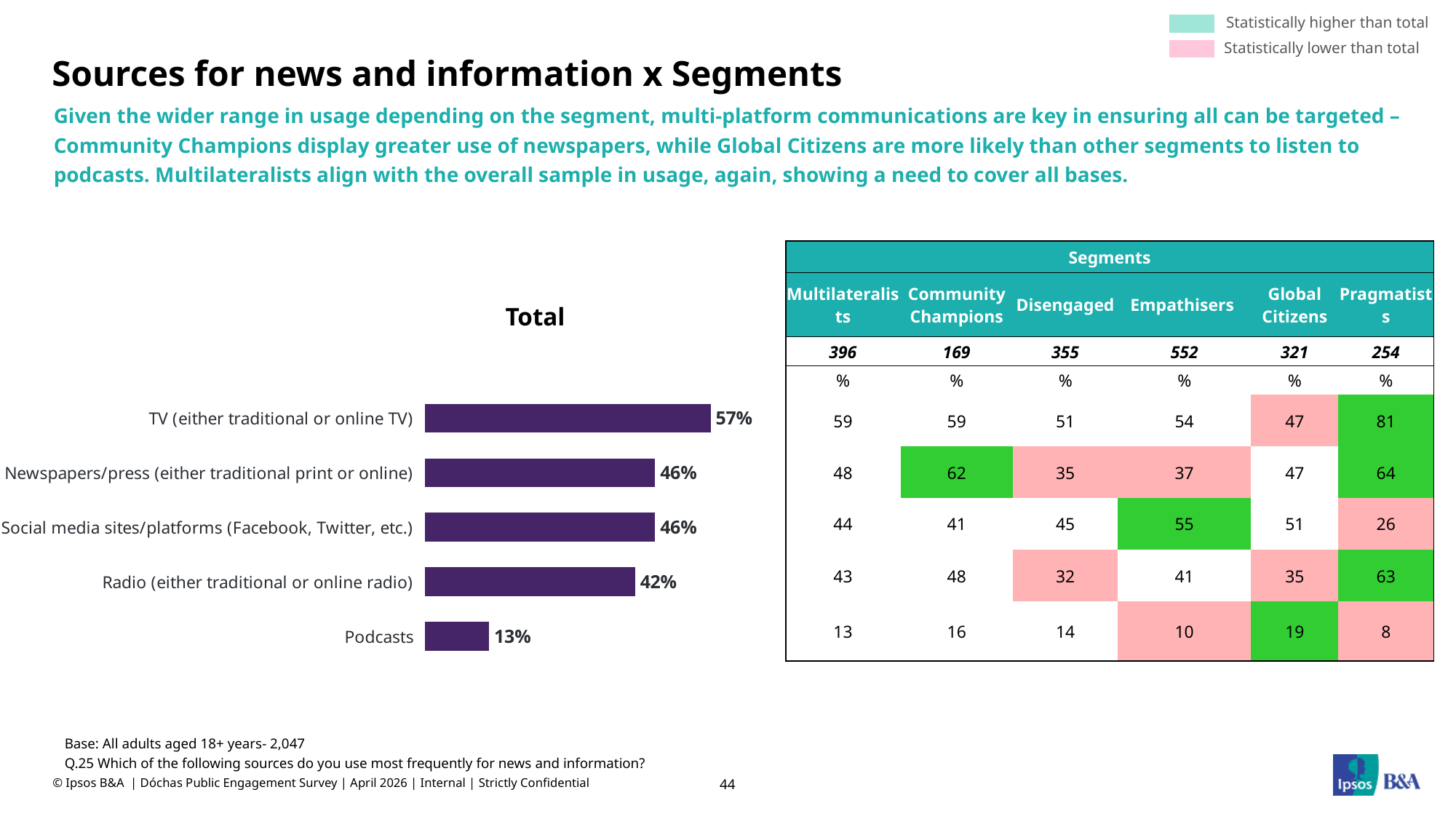
Which category has the highest value in the Total chart? TV (either traditional or online TV) What kind of chart is the Total chart? Bar chart What is the value for TV (either traditional or online TV) in the Total chart? 57% What is the difference between the values for TV (either traditional or online TV) and Podcasts in the Total chart? 44% What is the title of the chart on the slide? Total In the Total chart, which is larger: the value for Radio (either traditional or online radio) or the value for Podcasts? Radio (either traditional or online radio) How many categories are shown in the Total chart? 5 What colour are the bars in the Total chart? Purple Which category has the lowest value in the Total chart? Podcasts What is the value for Radio (either traditional or online radio) in the Total chart? 42% What is the value for Podcasts in the Total chart? 13% What is the difference between the values for Newspapers/press (either traditional print or online) and Radio (either traditional or online radio) in the Total chart? 4%